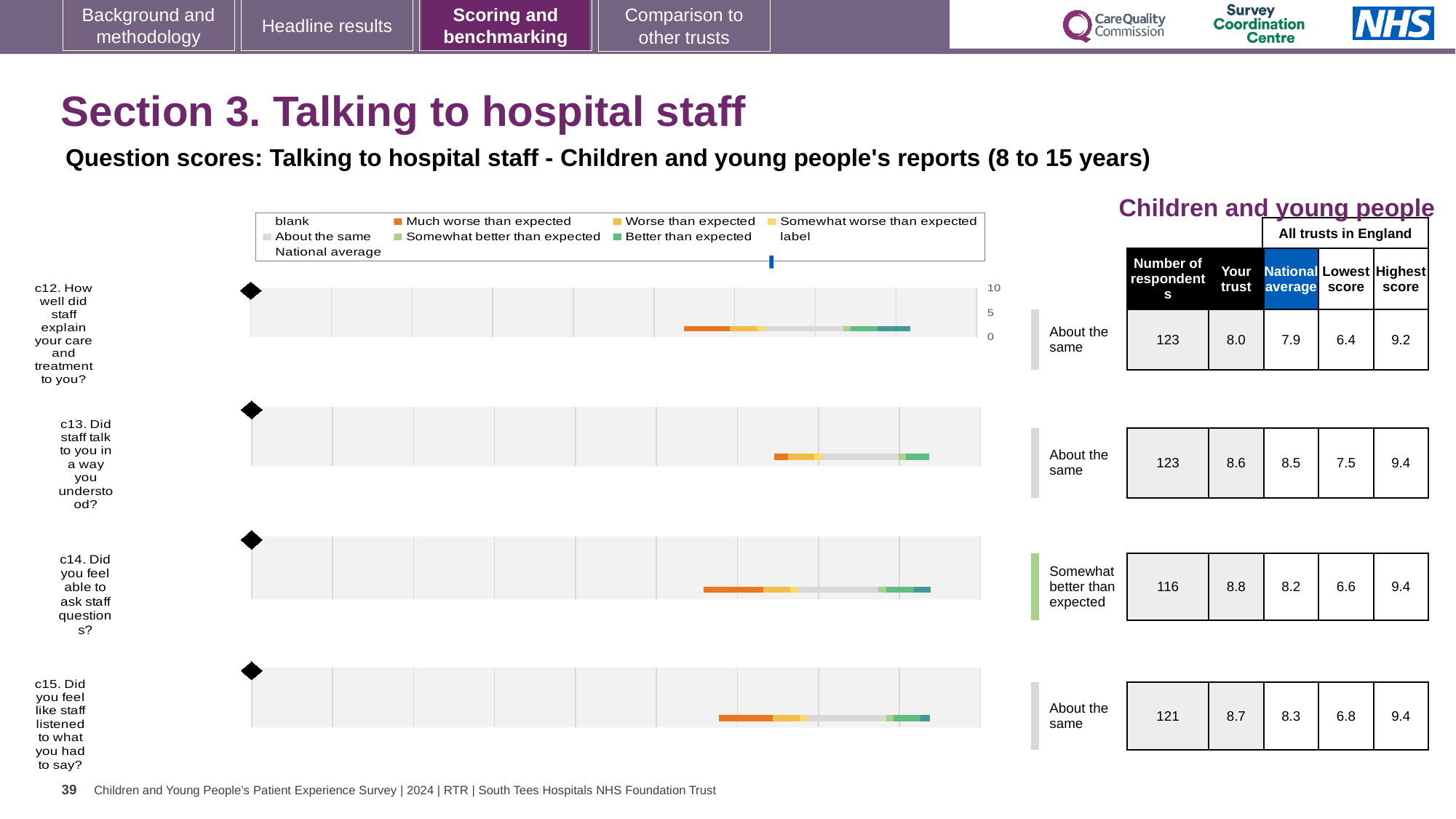
Which question has the highest 'Your trust' score on this slide? c14 Which question has the lowest 'Your trust' score on this slide? c12 What kind of chart is used to show the benchmark bands for each question (c12 to c15)? Bar chart In the chart legend, what colour represents 'Much worse than expected'? Orange For question c14, what is the difference between the 'Your trust' score and the national average? 0.6 For question c14 (Did you feel able to ask staff questions?), what is the national average score? 8.2 Which benchmark category is shown for question c14? Somewhat better than expected For question c15, what is the highest score among all trusts in England? 9.4 For question c13 (Did staff talk to you in a way you understood?), how many respondents are listed? 123 For question c15 (Did you feel like staff listened to what you had to say?), which is larger: the 'Your trust' score or the national average? Your trust How many questions (c12 to c15) have a chart on this slide? 4 For question c12 (How well did staff explain your care and treatment to you?), what is the 'Your trust' score shown in the table? 8.0